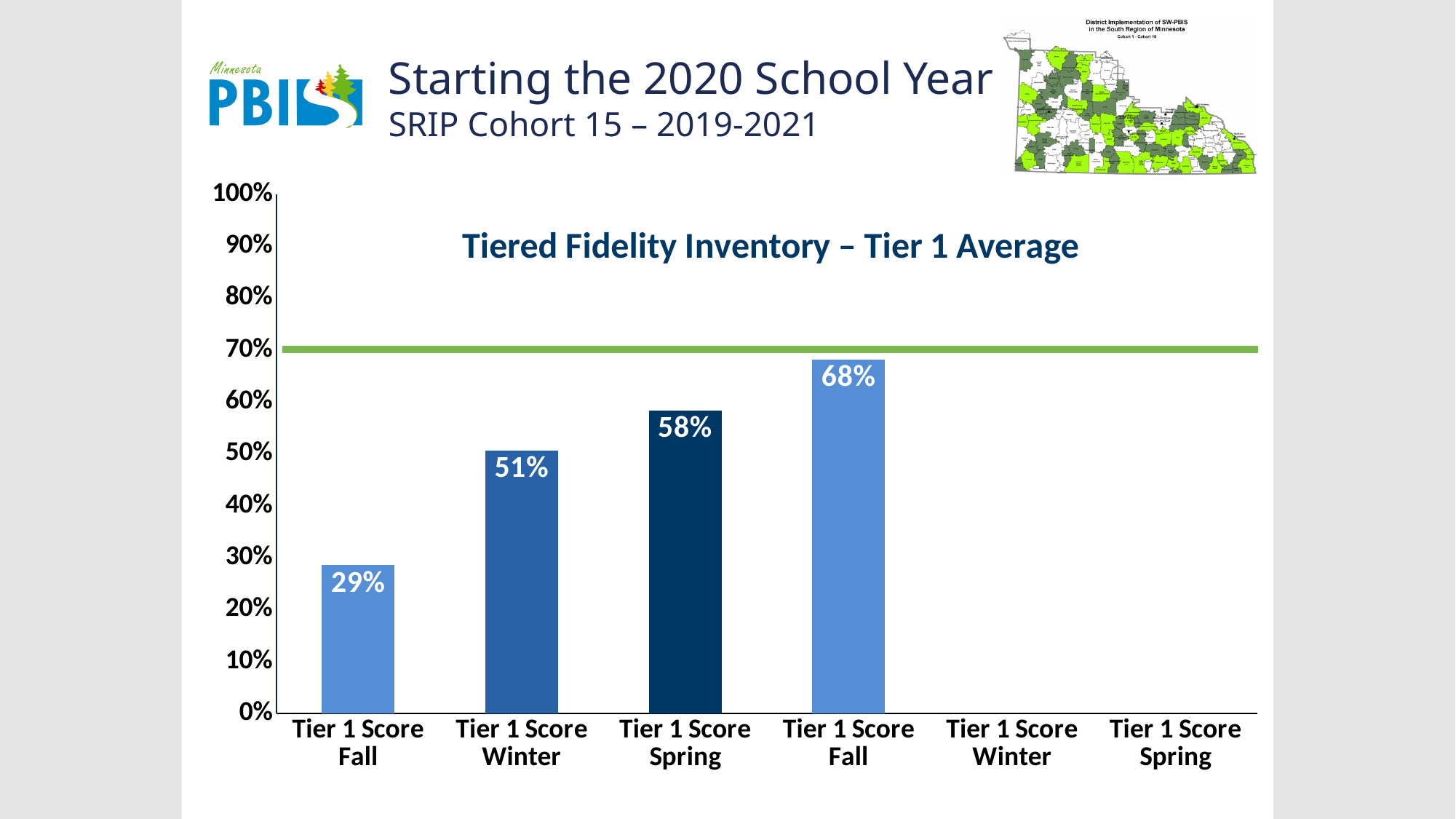
What is the difference between the Tier 1 Score Spring bar and the Tier 1 Score Winter bar? 7% Which bar has the highest value in the chart? The second Tier 1 Score Fall (68%) What is the value of the Tier 1 Score Winter bar that has a data label? 51% What is the value of the second Tier 1 Score Fall bar? 68% What is the value of the Tier 1 Score Spring bar that has a data label? 58% How many category labels are shown along the x axis of the chart? 6 Which is larger, the Tier 1 Score Winter bar or the Tier 1 Score Spring bar? Tier 1 Score Spring Which bar has the lowest value among the plotted bars? The first Tier 1 Score Fall (29%) What is the value of the first Tier 1 Score Fall bar in the Tiered Fidelity Inventory – Tier 1 Average chart? 29% What kind of chart is shown on the slide? Bar chart At what percentage is the horizontal green line drawn across the chart? 70% What is the difference between the second Tier 1 Score Fall bar (68%) and the first Tier 1 Score Fall bar (29%)? 39%